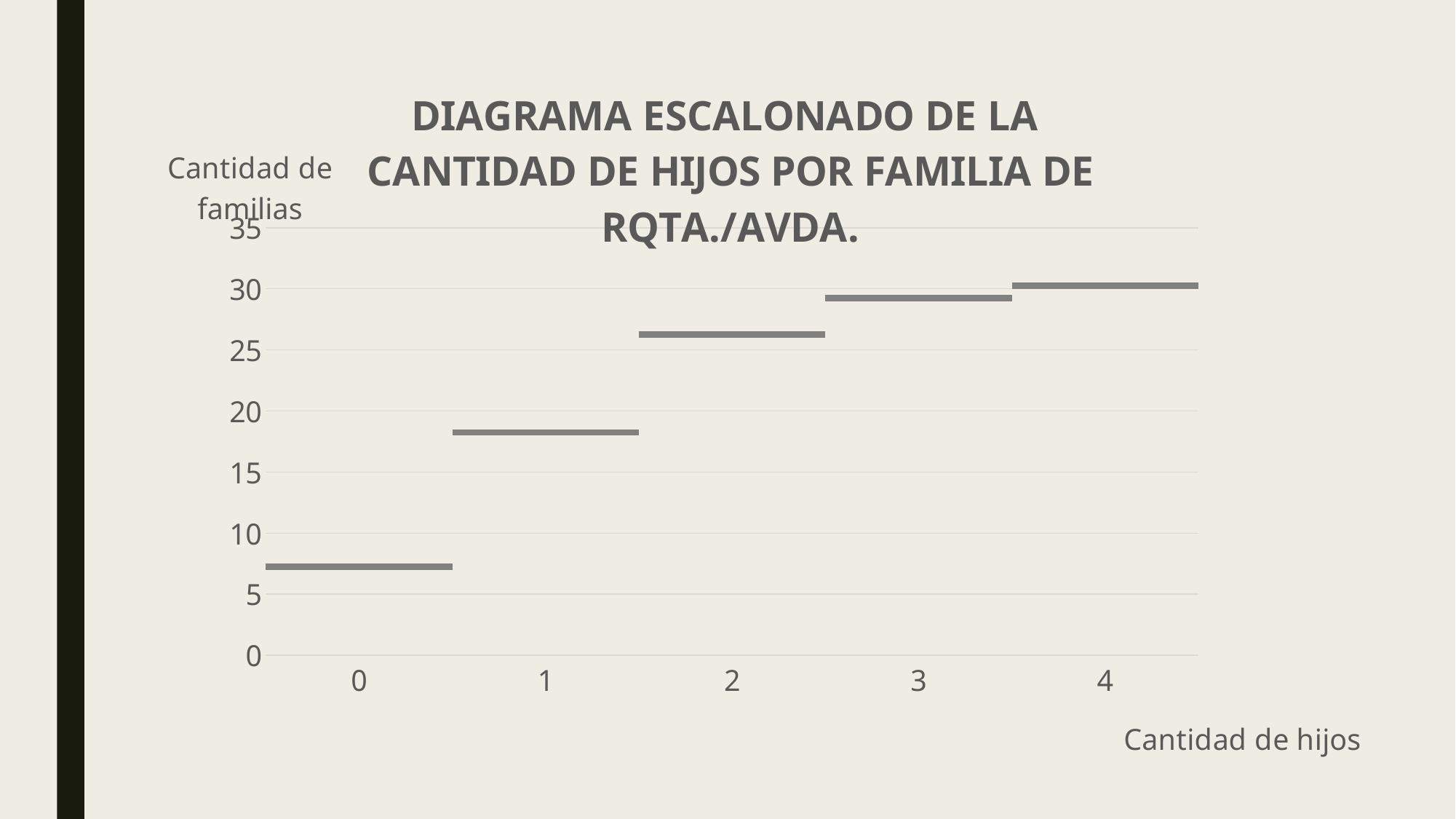
What is the title of the chart? DIAGRAMA ESCALONADO DE LA CANTIDAD DE HIJOS POR FAMILIA DE RQTA./AVDA. Which is larger, the value for 1 hijo or the value for 3 hijos? 3 hijos Do the values rise or fall as Cantidad de hijos increases along the x axis? rise Is the value for 1 hijo greater or less than 15? greater Which Cantidad de hijos value has the highest Cantidad de familias on the chart? 4 Is the value for 0 hijos greater or less than 10? less Is the value for 2 hijos greater or less than 25? greater What is the label of the horizontal axis? Cantidad de hijos What kind of chart is shown on the slide? step chart How many steps (categories of Cantidad de hijos) are plotted on the chart? 5 Which Cantidad de hijos value has the lowest Cantidad de familias on the chart? 0